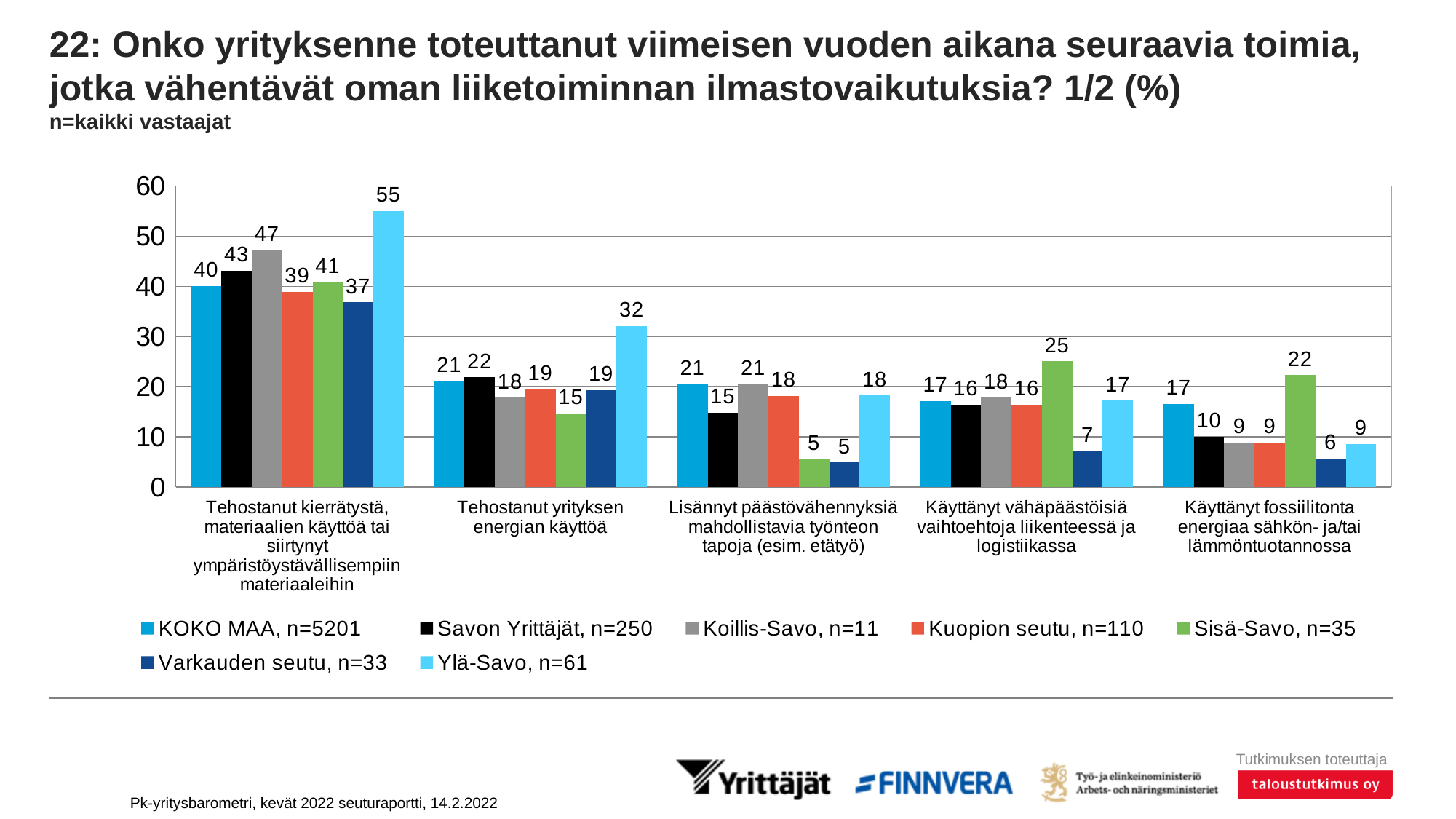
What is the value for Ylä-Savo, n=61 in the category 'Tehostanut kierrätystä, materiaalien käyttöä tai siirtynyt ympäristöystävällisempiin materiaaleihin'? 55 What is the value for KOKO MAA, n=5201 in the category 'Käyttänyt fossiilitonta energiaa sähkön- ja/tai lämmöntuotannossa'? 17 What is the value for Sisä-Savo, n=35 in the category 'Käyttänyt vähäpäästöisiä vaihtoehtoja liikenteessä ja logistiikassa'? 25 Is the value for Koillis-Savo, n=11 in the category 'Tehostanut kierrätystä, materiaalien käyttöä tai siirtynyt ympäristöystävällisempiin materiaaleihin' greater or less than 40? greater Which series has the lowest value in the category 'Käyttänyt fossiilitonta energiaa sähkön- ja/tai lämmöntuotannossa'? Varkauden seutu, n=33 How many categories are shown on the x axis of the chart? 5 How many series does the legend list? 7 What is the value for Varkauden seutu, n=33 in the category 'Käyttänyt vähäpäästöisiä vaihtoehtoja liikenteessä ja logistiikassa'? 7 What is the difference between the Ylä-Savo, n=61 value and the KOKO MAA, n=5201 value in the category 'Tehostanut yrityksen energian käyttöä'? 11 What kind of chart is shown on the slide? bar chart Which series has the highest value in the category 'Tehostanut yrityksen energian käyttöä'? Ylä-Savo, n=61 In the category 'Lisännyt päästövähennyksiä mahdollistavia työnteon tapoja (esim. etätyö)', which is larger: the value for Savon Yrittäjät, n=250 or the value for Kuopion seutu, n=110? Kuopion seutu, n=110